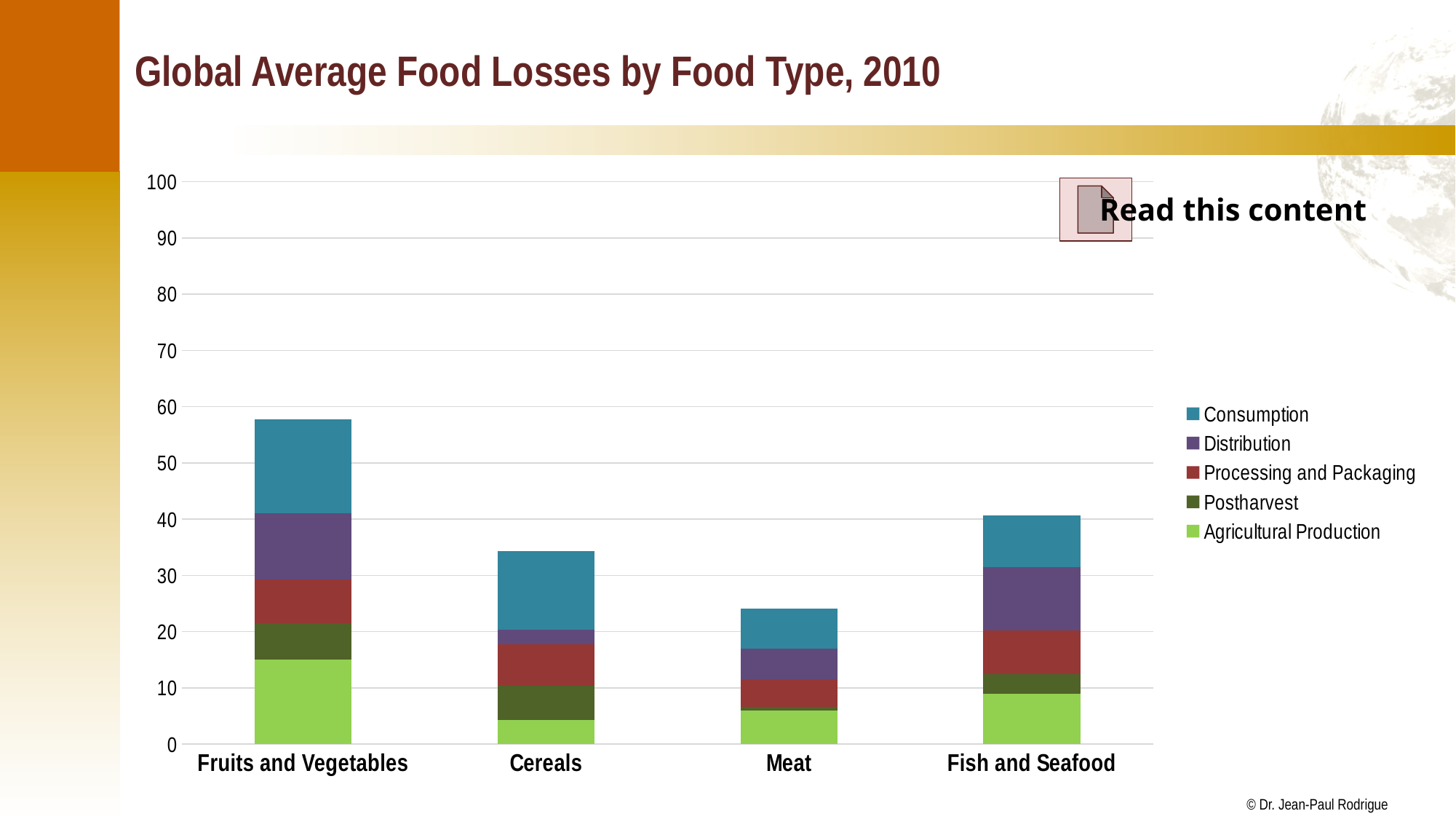
Is the Agricultural Production value for Cereals greater or less than 10? less Is the total value for Fruits and Vegetables greater or less than 50? greater Is the total value for Meat greater or less than 30? less What kind of chart is shown on the slide? Stacked bar chart What is the title of the chart? Global Average Food Losses by Food Type, 2010 Which series is shown at the bottom of each stacked bar? Agricultural Production How many food type categories are shown on the x axis? 4 How many series does the legend list? 5 Which food type has the lowest total food losses? Meat Which has a larger total bar, Cereals or Fish and Seafood? Fish and Seafood Which food type has the highest total food losses? Fruits and Vegetables